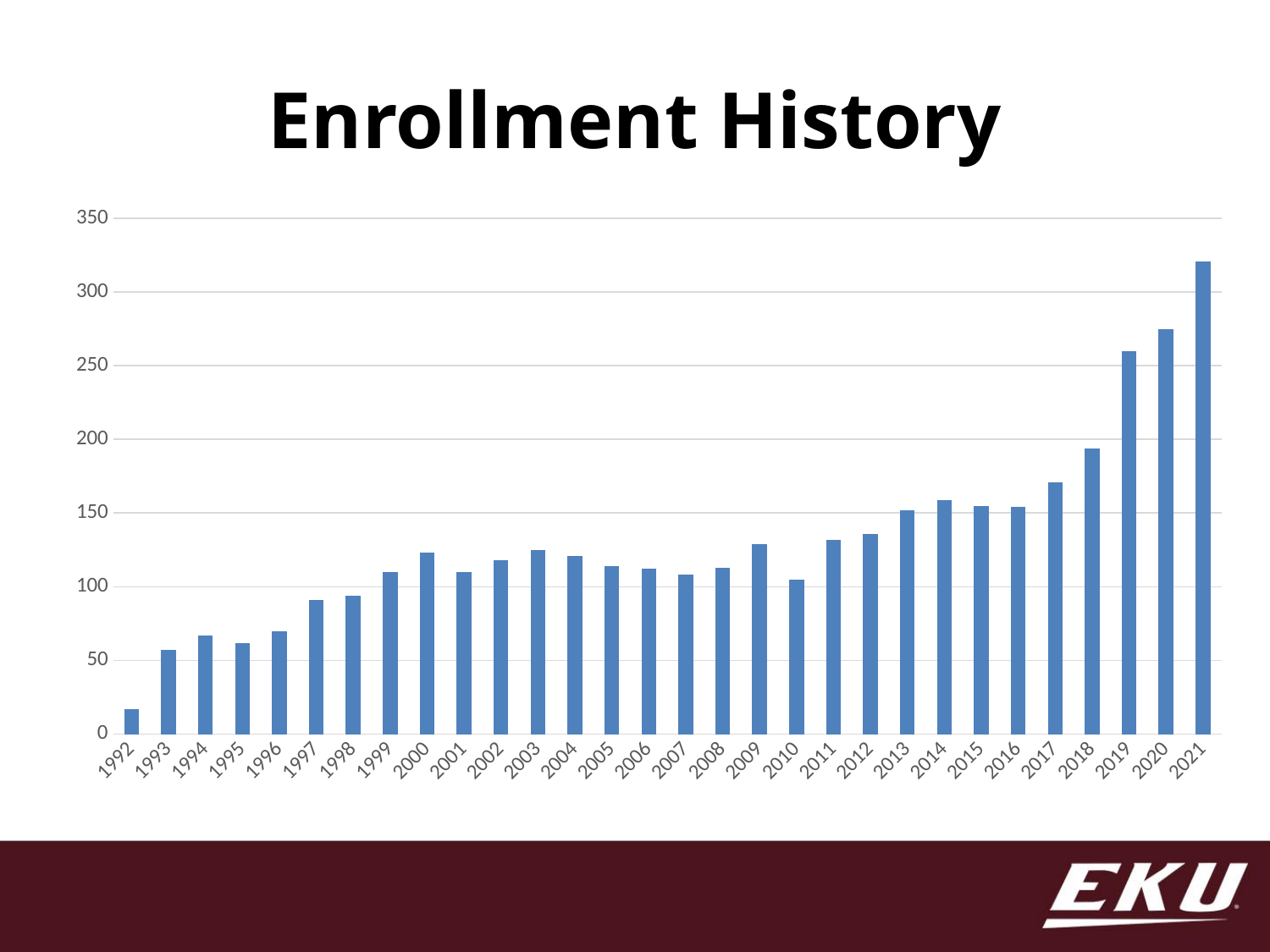
Is the value for 1992 greater or less than 50? less How many years are shown on the x axis of the chart? 30 Is the value for 1997 greater or less than 100? less What kind of chart is shown on the slide? Bar chart Which is larger, the value for 2020 or the value for 2017? 2020 Is the value for 2019 greater or less than 250? greater What is the title of the chart? Enrollment History Which year has the lowest enrollment? 1992 Overall, do enrollment values rise or fall from 1992 to 2021? rise Which year has the highest enrollment? 2021